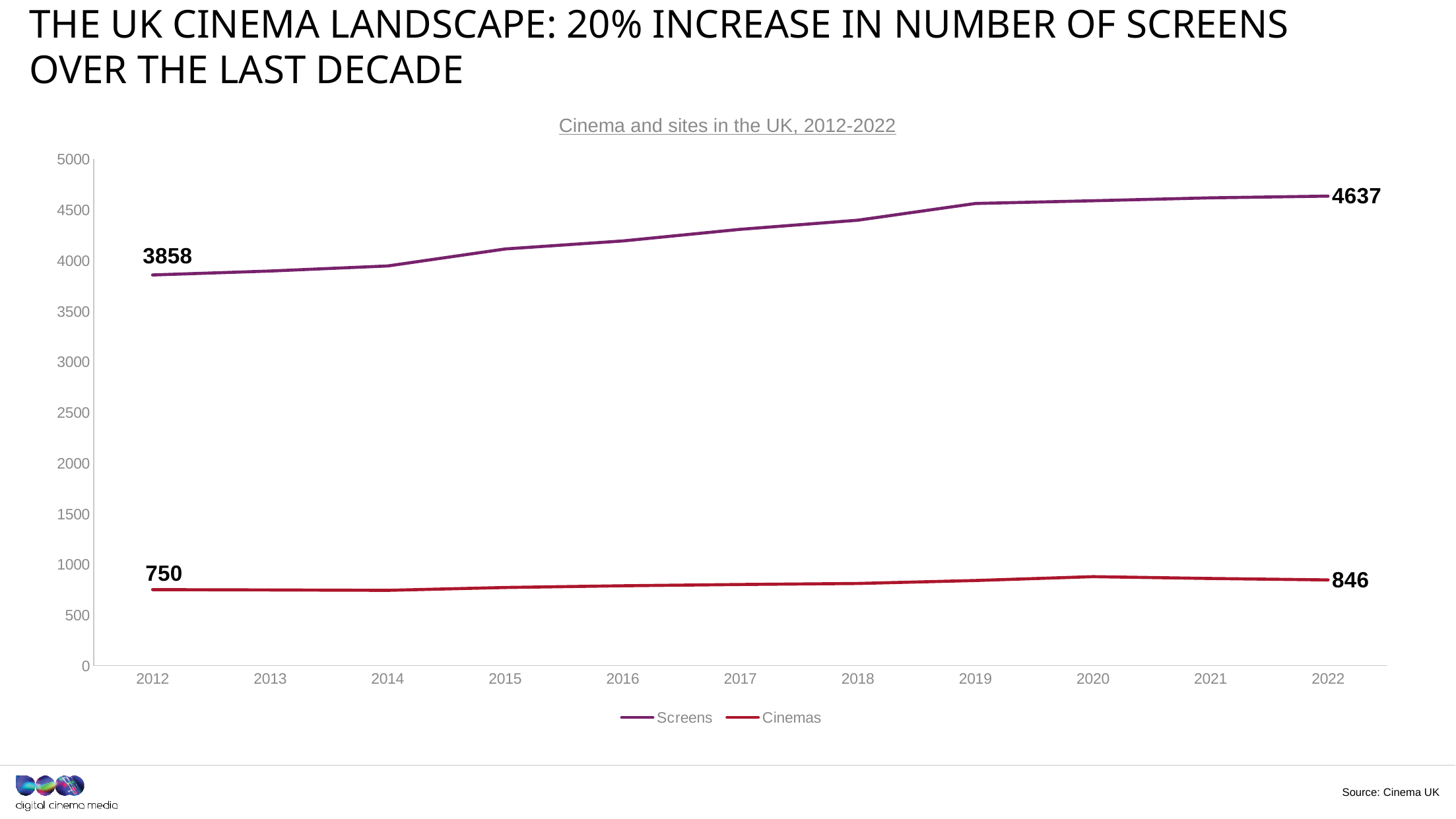
How many series does the legend list? 2 What is the value for Cinemas in 2022? 846 What is the value for Cinemas in 2012? 750 What is the value for Screens in 2012? 3858 Is the value for Screens in 2016 greater or less than 4000? greater What is the difference between the Cinemas values in 2022 and 2012? 96 What is the difference between the Screens values in 2022 and 2012? 779 What is the value for Screens in 2022? 4637 How many years are shown on the x axis? 11 What kind of chart is shown on the slide? Line chart Which series has the higher value in 2022, Screens or Cinemas? Screens Is the value for Cinemas in 2017 greater or less than 1000? less